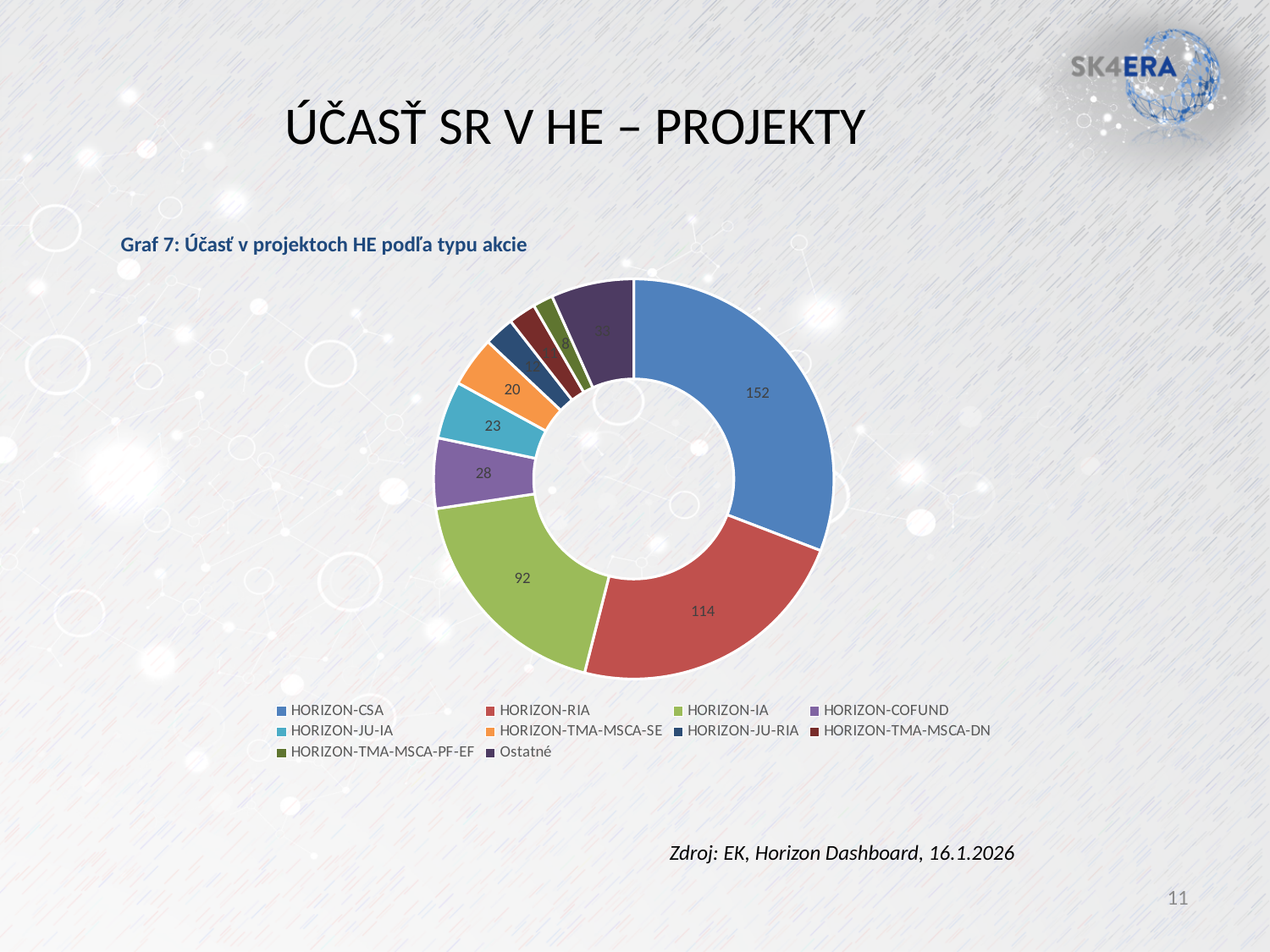
What is the difference between the values for HORIZON-CSA and HORIZON-RIA? 38 What is the value for HORIZON-IA? 92 What is the value for HORIZON-RIA? 114 Which is larger, the value for HORIZON-JU-IA or the value for HORIZON-TMA-MSCA-SE? HORIZON-JU-IA What is the value for HORIZON-CSA? 152 What is the value for HORIZON-COFUND? 28 What is the value for Ostatné? 33 What kind of chart is shown on the slide? Doughnut (pie) chart What colour is the slice for HORIZON-IA? Green What is the title of the chart? Graf 7: Účasť v projektoch HE podľa typu akcie Which category has the largest slice? HORIZON-CSA How many categories does the legend list? 10